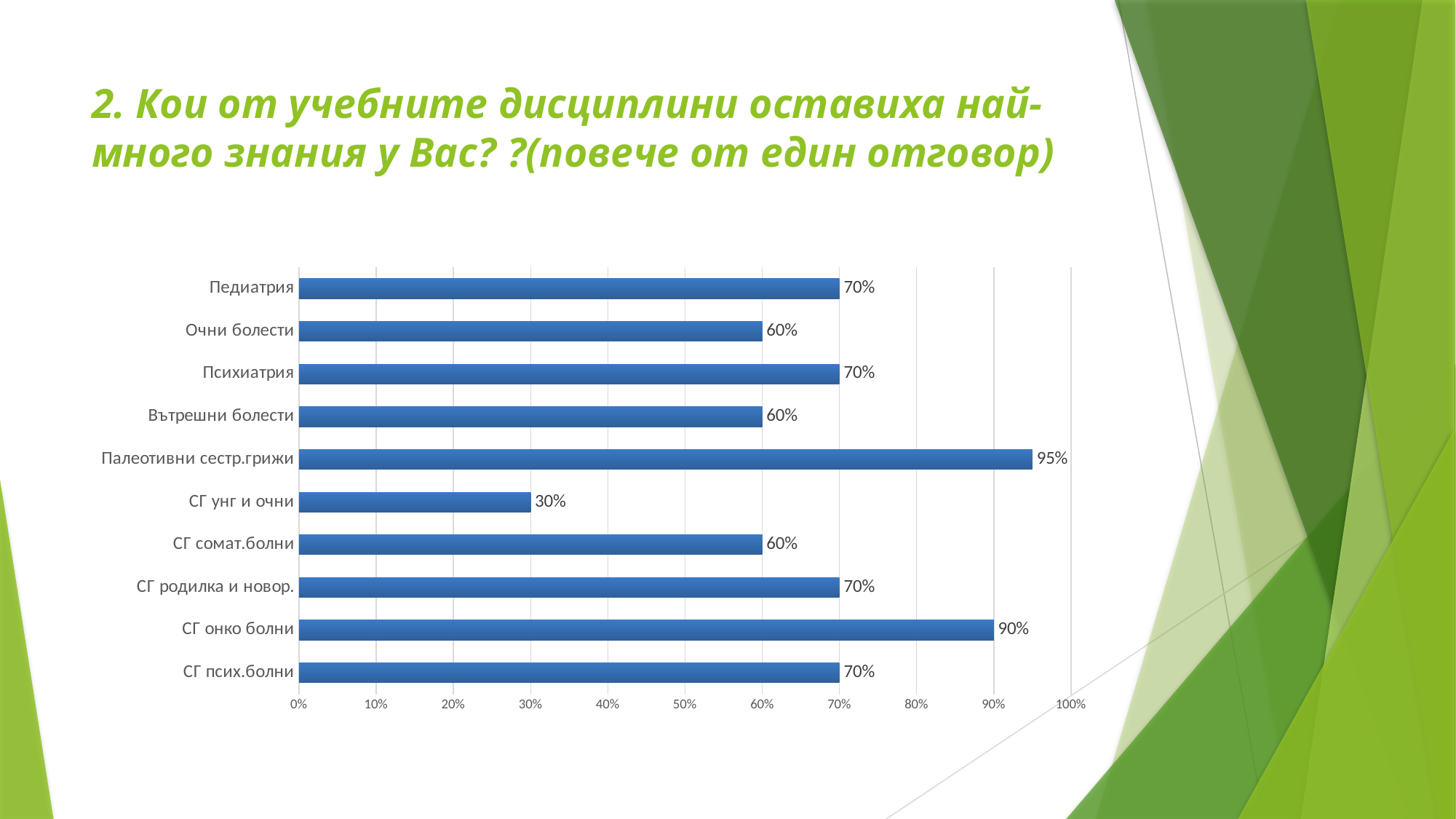
What is the difference between Педиатрия and СГ унг и очни? 40% Which is larger, Психиатрия or Вътрешни болести? Психиатрия Which category has the highest value? Палеотивни сестр.грижи What is the value for Палеотивни сестр.грижи? 95% What is the value for Очни болести? 60% What is the value for СГ онко болни? 90% What is the value for СГ унг и очни? 30% Which category has the lowest value? СГ унг и очни What is the difference between Палеотивни сестр.грижи and СГ онко болни? 5% What kind of chart is shown on the slide? Bar chart How many categories are shown in the chart? 10 Is the value for СГ онко болни greater or less than 80%? greater